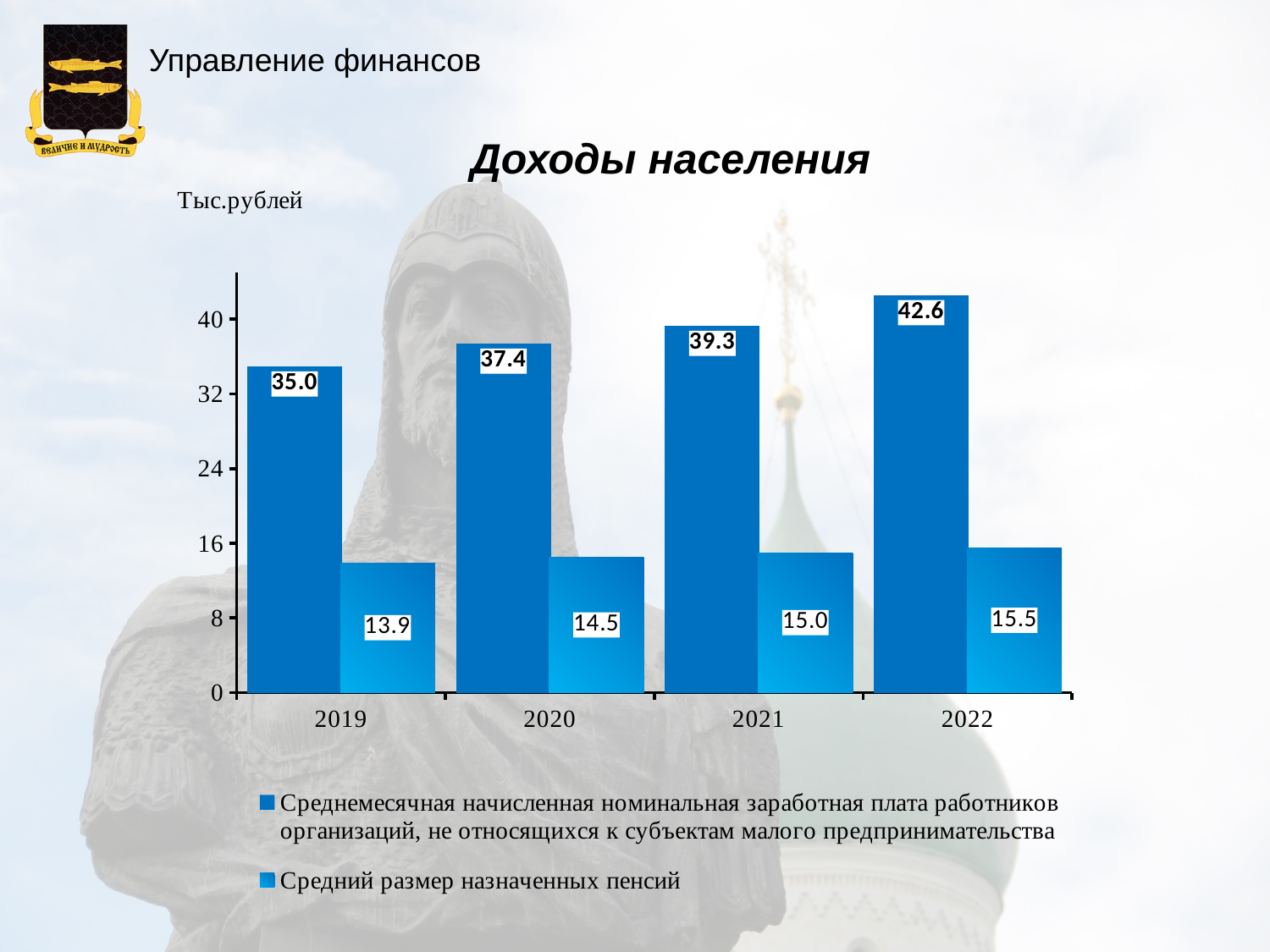
What is the difference between the average monthly wage in 2022 and in 2019? 7.6 What is the average assigned pension value for 2022? 15.5 How many series does the legend list? 2 In which year is the average assigned pension lowest? 2019 How many years are shown on the x axis? 4 What is the average assigned pension (Средний размер назначенных пенсий) for 2019? 13.9 In which year is the average monthly wage highest? 2022 What is the difference between the average wage and the average pension in 2020? 22.9 Do the average monthly wage values rise or fall from 2019 to 2022? rise What is the average monthly nominal wage (Среднемесячная начисленная номинальная заработная плата) for 2021? 39.3 Which is larger: the average pension in 2021 or in 2020? 2021 What kind of chart is shown on the slide? bar chart